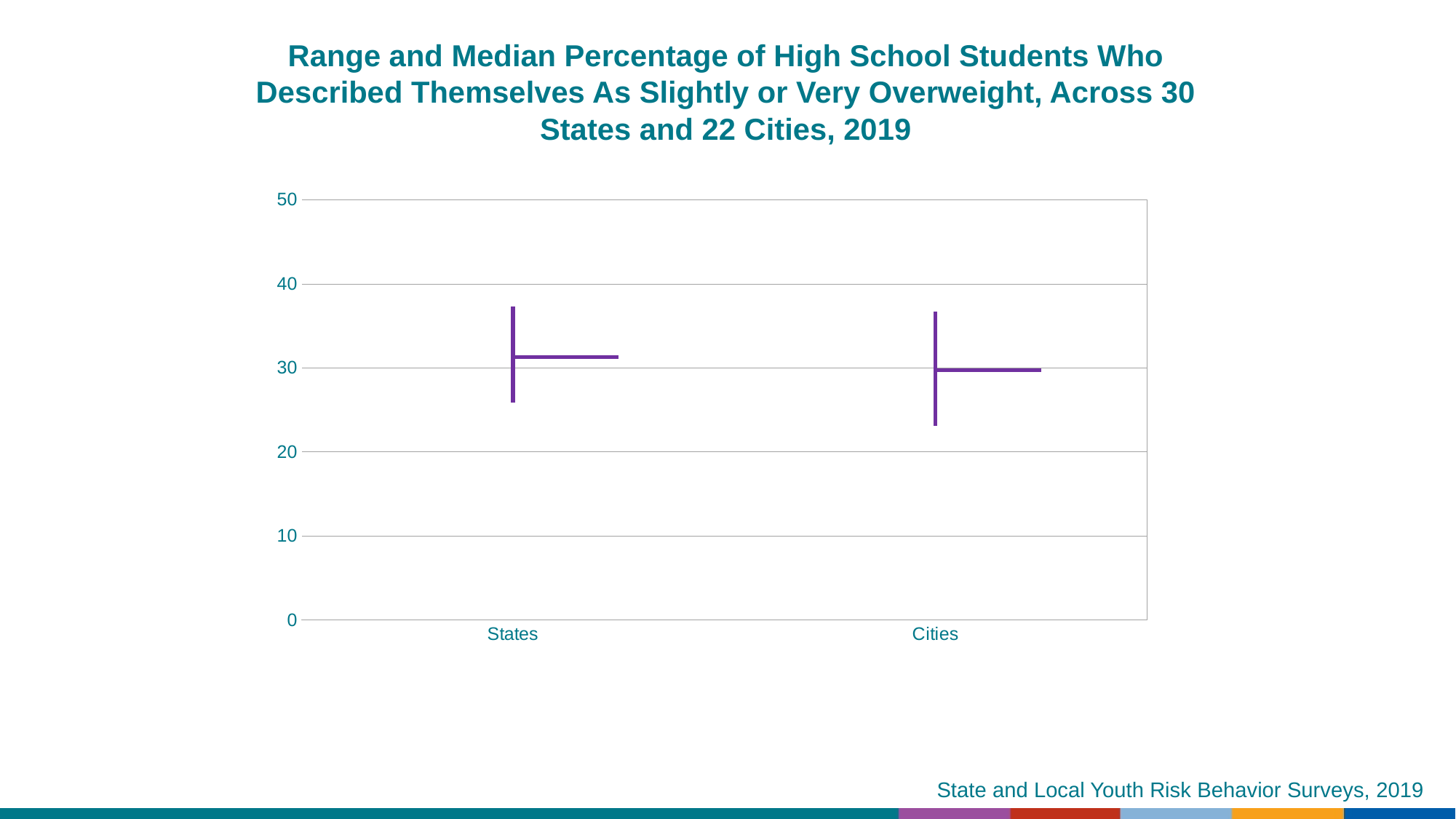
Is the median value for States greater or less than 30? greater Which category has the lower bottom of its range, States or Cities? Cities Which category has the higher median, States or Cities? States What kind of chart is shown on the slide? High-low range chart How many categories are shown on the x axis of the chart? 2 Is the bottom of the range for Cities greater or less than 20? greater What are the two categories shown on the x axis? States and Cities What is the highest value shown on the y axis? 50 Is the top of the range for States greater or less than 40? less